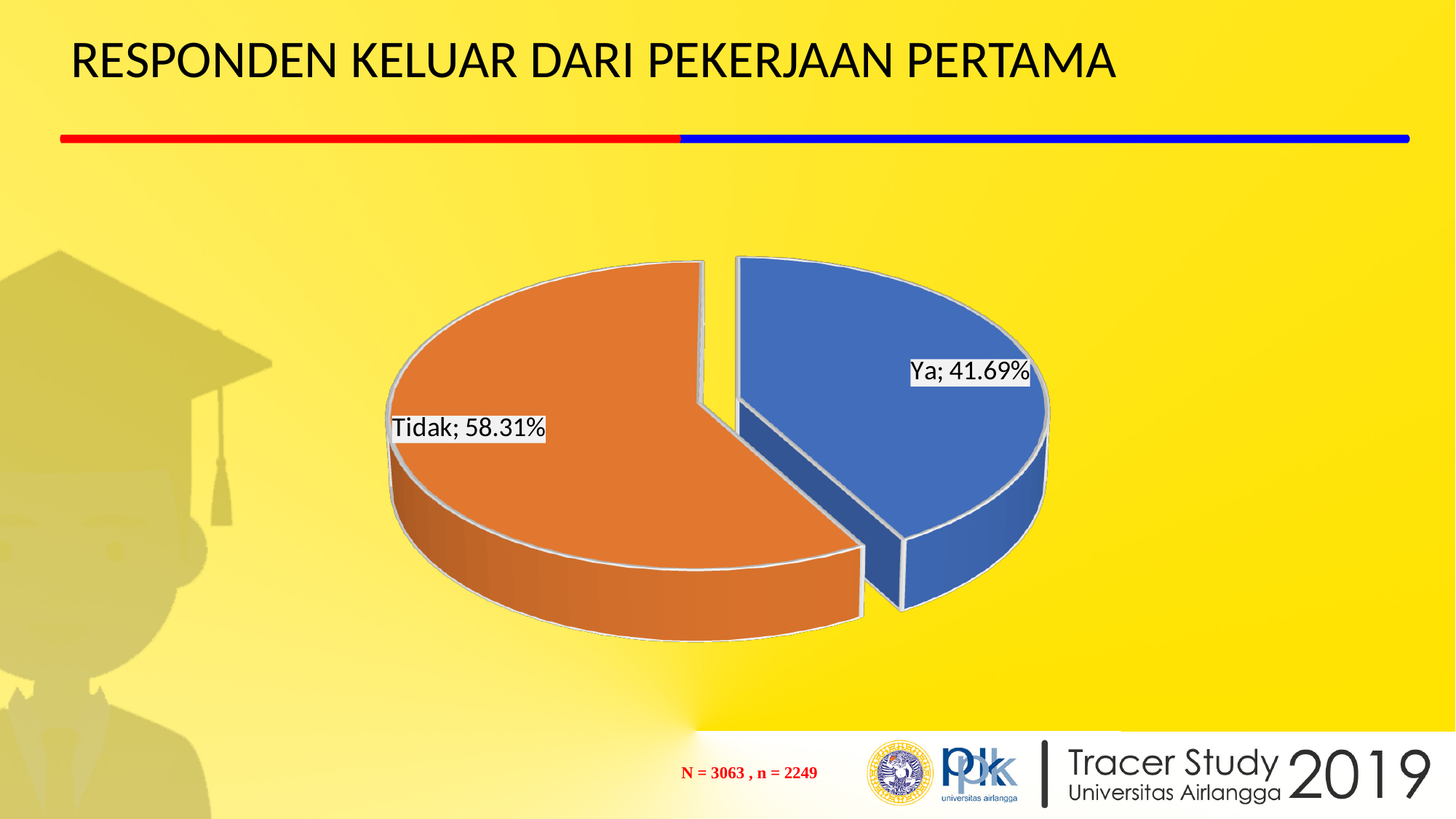
What share of the pie does the "Tidak" slice represent? 58.31% Which is larger, the share for "Ya" or the share for "Tidak"? Tidak How many categories are shown in the pie chart? 2 What kind of chart is shown on the slide? Pie chart What percentage of respondents answered "Tidak"? 58.31% What percentage of respondents answered "Ya"? 41.69% Which category has the largest share of the pie? Tidak What is the difference in percentage points between "Tidak" and "Ya"? 16.62 What is the title of the slide? RESPONDEN KELUAR DARI PEKERJAAN PERTAMA What colour is the "Ya" slice of the pie chart? Blue Which category has the smallest share of the pie? Ya